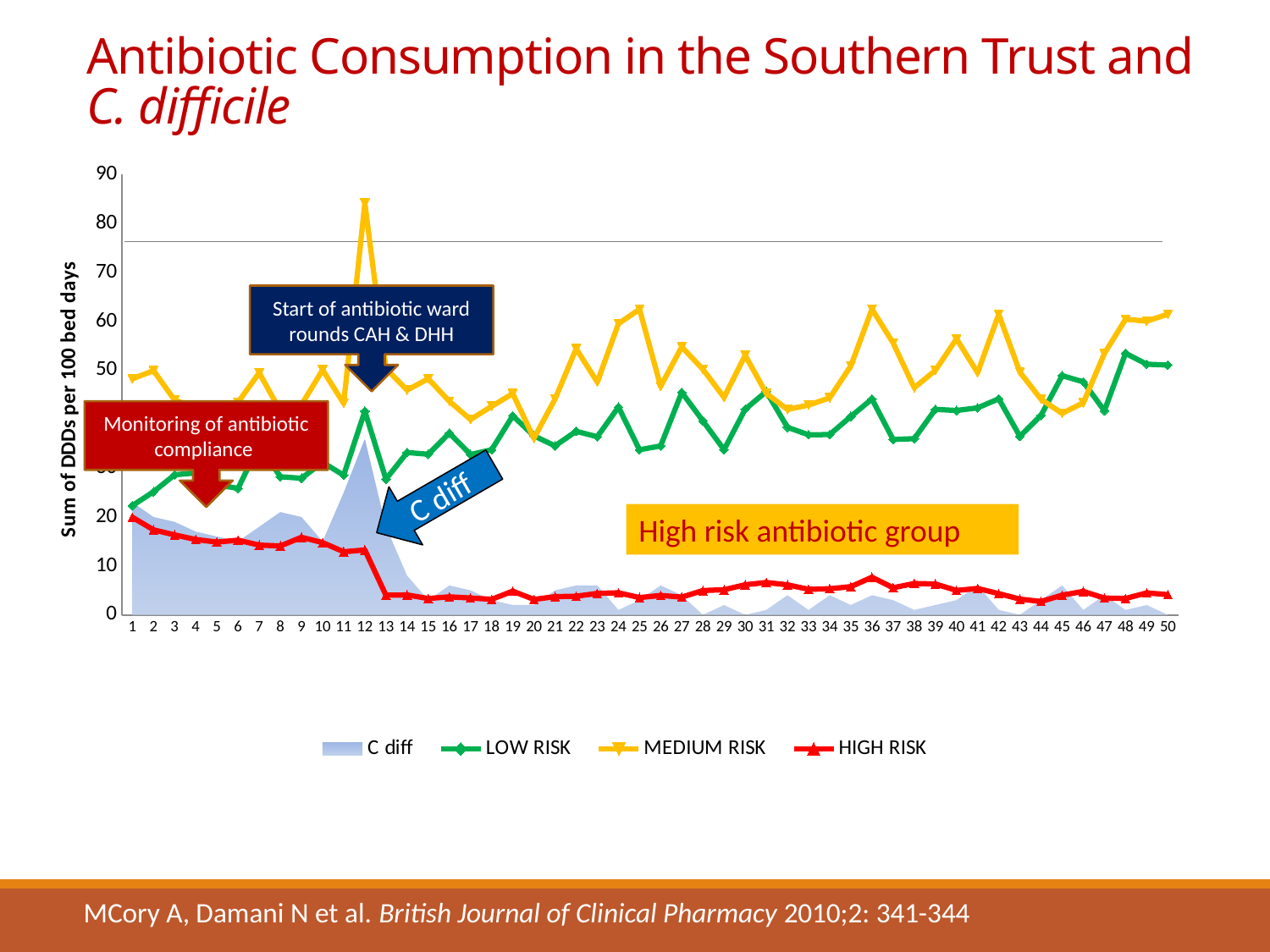
Is the MEDIUM RISK value at point 20 greater or less than 40? less Is the LOW RISK value at point 27 greater or less than 40? greater What kind of chart is shown on the slide? Line chart (with a shaded area series) Is the MEDIUM RISK value at point 12 greater or less than 80? greater At point 12, which series has the larger value, MEDIUM RISK or LOW RISK? MEDIUM RISK Does the HIGH RISK series generally rise or fall from point 1 to point 50? fall What is the label on the chart's y axis? Sum of DDDs per 100 bed days Which series reaches the highest value anywhere on the chart? MEDIUM RISK How many points are there along the x axis of the chart? 50 How many series does the chart legend list? 4